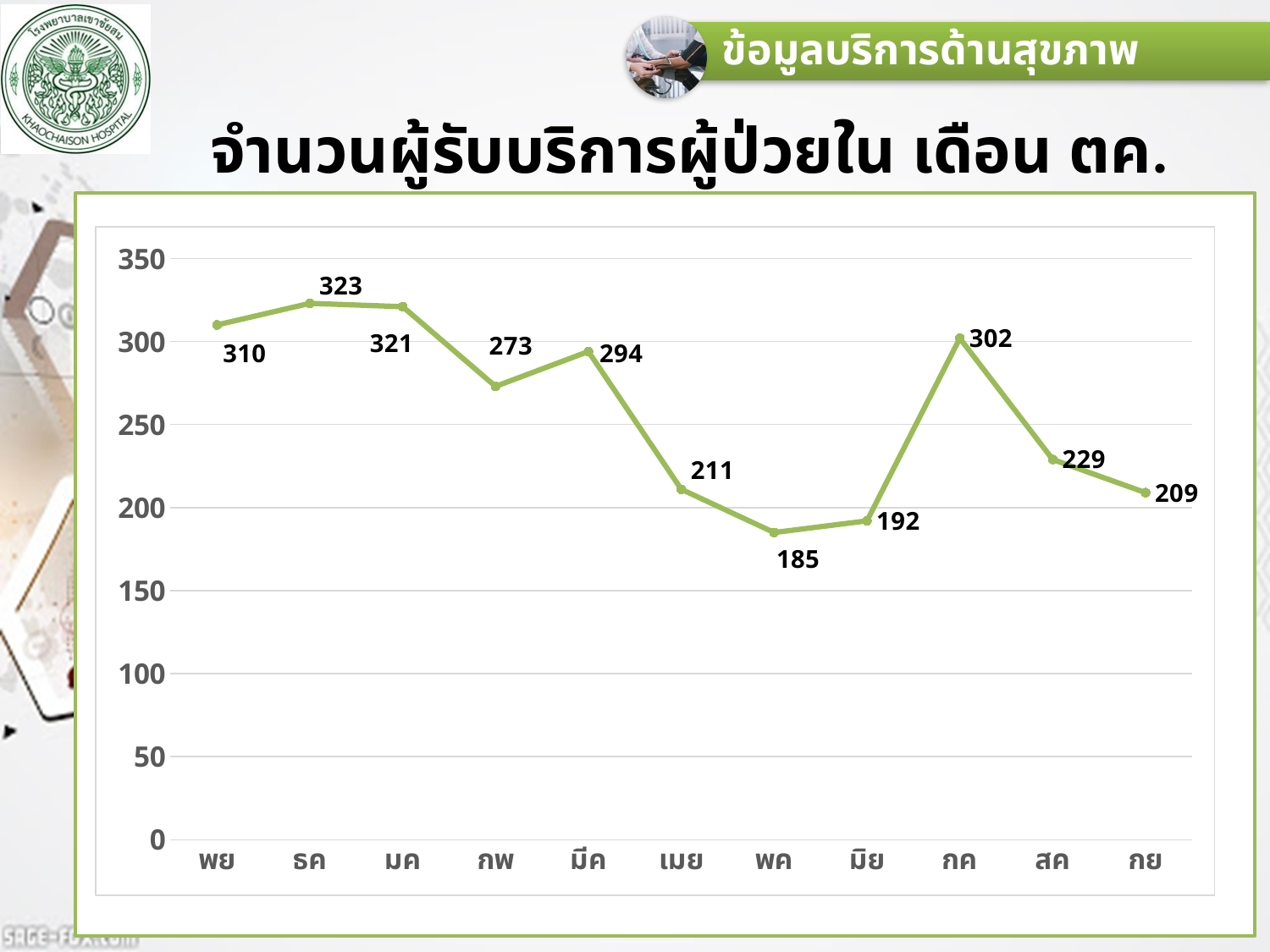
Which is larger, the value for กพ or the value for มีค? มีค Which month has the highest value? ธค What is the difference between the values for กค and สค? 73 What is the difference between the values for ธค and พค? 138 How many months are plotted on the x axis? 11 What kind of chart is shown on the slide? Line chart What is the value for กค? 302 What is the value for กย? 209 Do the values rise or fall from มิย to กค? Rise What is the value for ธค? 323 What is the value for พค? 185 Which month has the lowest value? พค